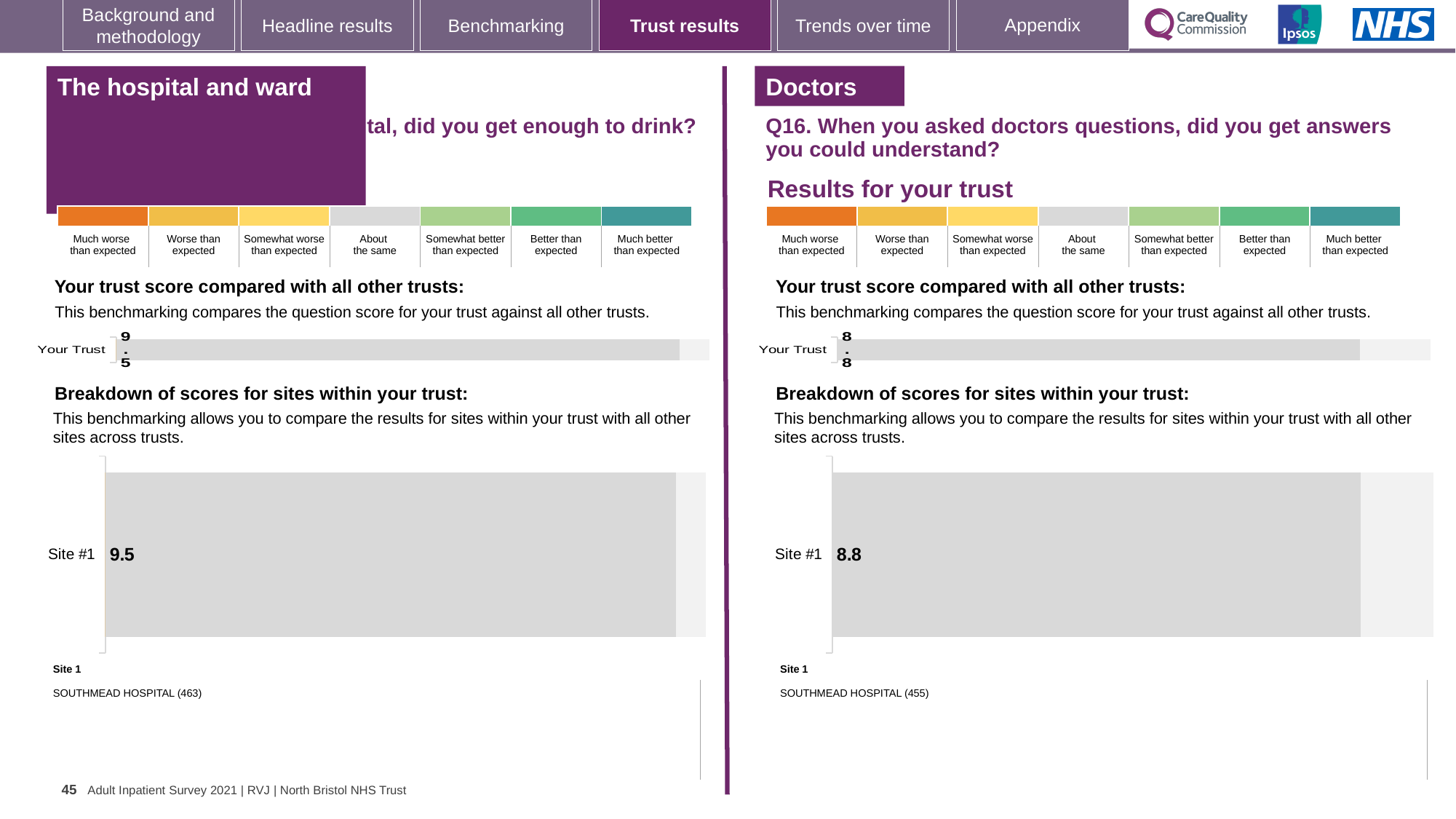
In the left panel's 'Breakdown of scores for sites within your trust' chart, what is the score for Site #1? 9.5 In the right panel's 'Breakdown of scores for sites within your trust' chart, what is the score for Site #1? 8.8 Which panel shows the higher 'Your Trust' score: the left (The hospital and ward) or the right (Doctors, Q16)? The left (The hospital and ward) On the left panel (The hospital and ward), what is the 'Your Trust' score in the 'Your trust score compared with all other trusts' chart? 9.5 What is the difference between the 'Your Trust' score on the left panel and the 'Your Trust' score on the right panel? 0.7 What type of chart is used for the 'Your Trust' score on the right panel? Bar chart On the right panel, which hospital is listed as Site 1 below the breakdown chart? SOUTHMEAD HOSPITAL (455) On the left panel, which hospital is listed as Site 1 below the breakdown chart? SOUTHMEAD HOSPITAL (463) How many sites are shown in the left panel's 'Breakdown of scores for sites within your trust' chart? 1 How many sites are shown in the right panel's 'Breakdown of scores for sites within your trust' chart? 1 On the right panel (Doctors, Q16), what is the 'Your Trust' score in the 'Your trust score compared with all other trusts' chart? 8.8 Which panel's Site #1 has the higher score: the left or the right? The left